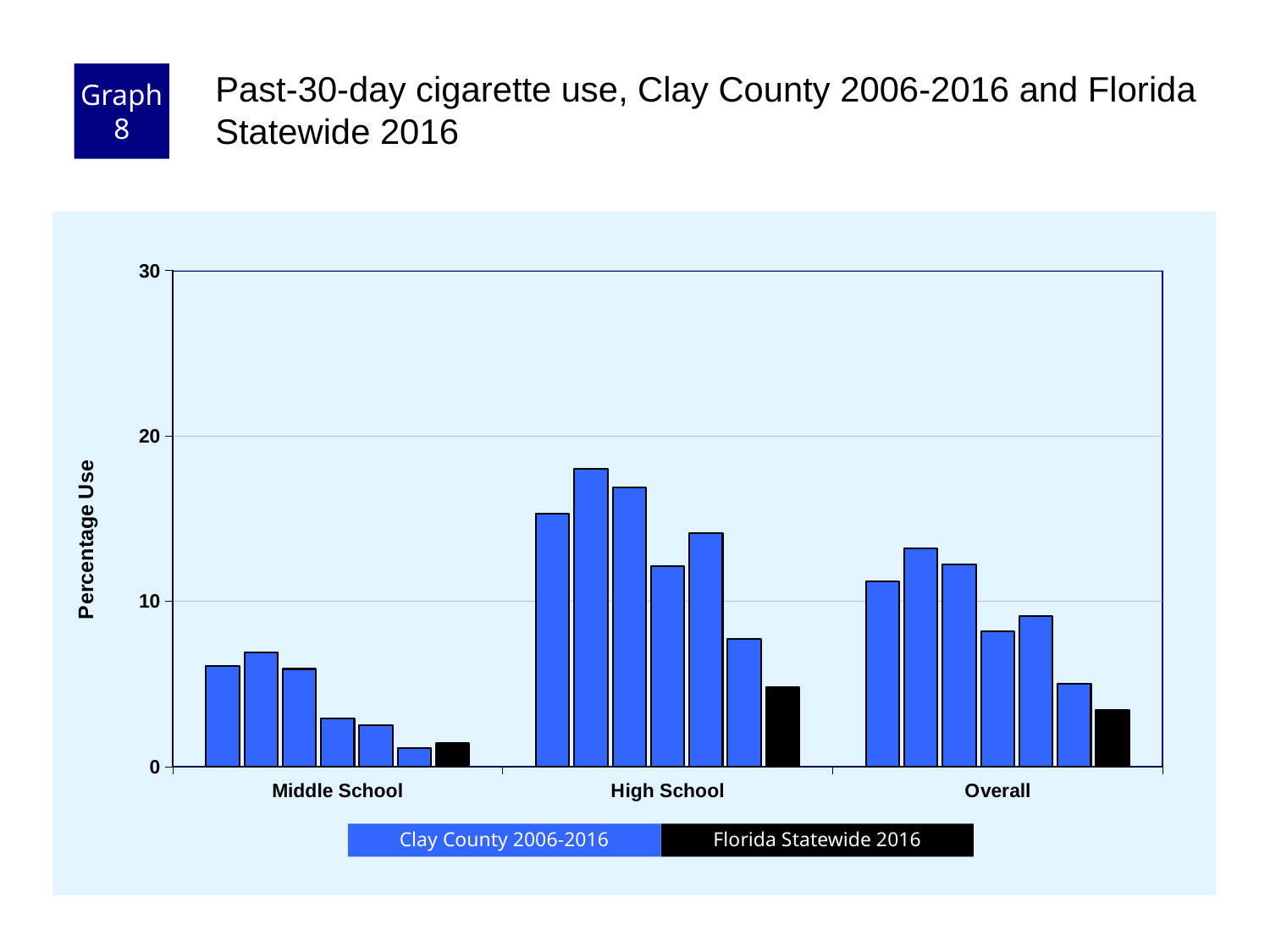
Is the tallest Clay County 2006-2016 bar for Overall greater or less than 10? greater Is the Florida Statewide 2016 value for High School greater or less than 10? less Which category has the lowest bars overall? Middle School What colour are the Florida Statewide 2016 bars? black Within the Middle School group, do the Clay County 2006-2016 bars generally rise or fall from left to right? fall Is the tallest Clay County 2006-2016 bar for High School greater or less than 20? less Which category has the tallest bar in the chart? High School What is the label on the y axis? Percentage Use How many series does the legend list? 2 Which is larger, the Florida Statewide 2016 bar for High School or the Florida Statewide 2016 bar for Middle School? High School What kind of chart is shown on the slide? bar chart How many categories are shown on the x axis? 3